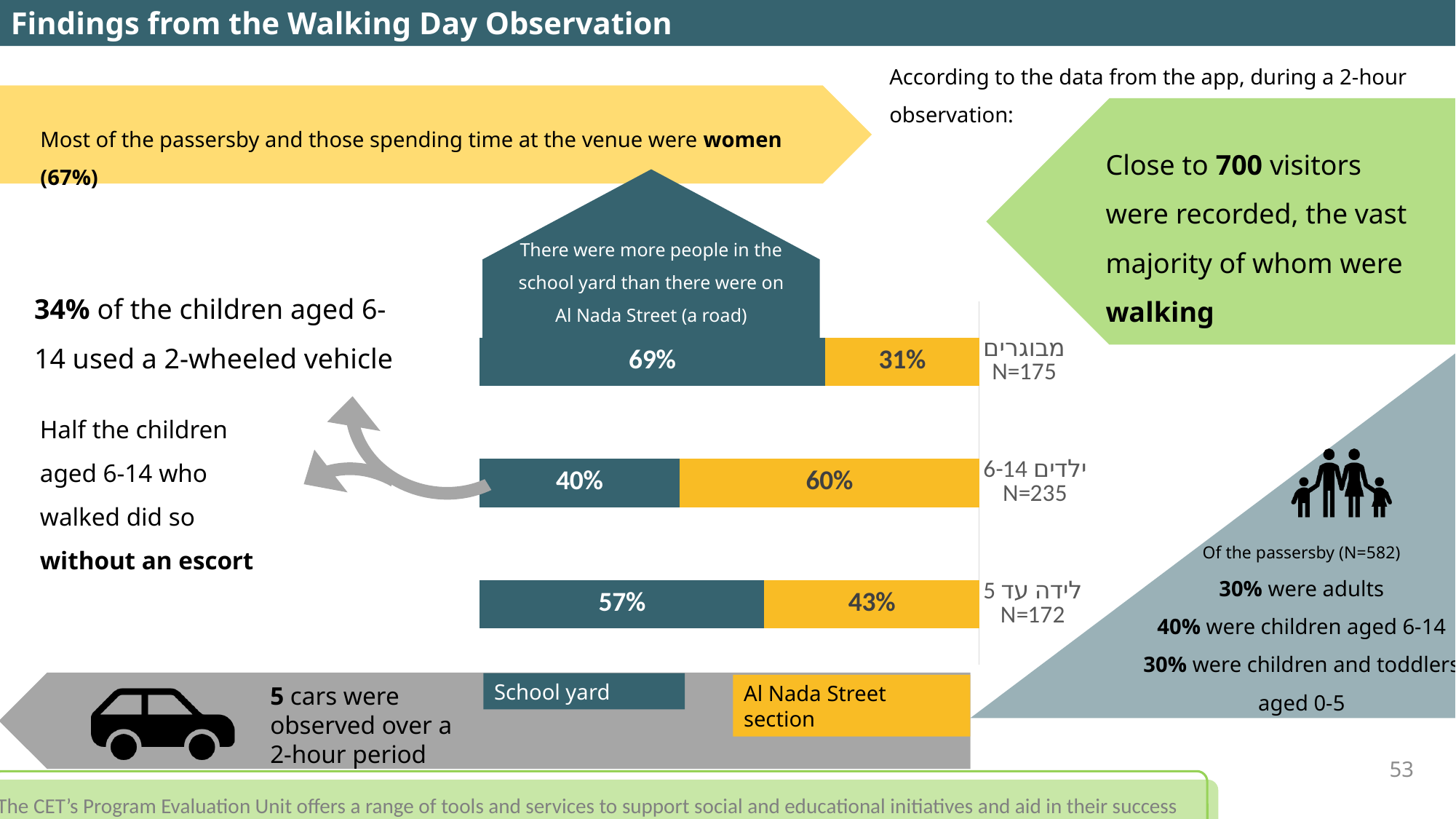
What is the School yard value for the category labelled N=172? 57% What is the difference between the School yard and Al Nada Street section values for the category labelled N=172? 14% What kind of chart is shown in the middle of the slide? stacked bar chart How many categories (bars) does the chart show? 3 Which colour represents the Al Nada Street section series in the chart? orange Which category has the highest School yard value? מבוגרים N=175 What is the Al Nada Street section value for the category labelled N=235? 60% What is the Al Nada Street section value for the category labelled N=175? 31% Which category has the lowest School yard value? ילדים 6-14 N=235 What is the School yard value for the category labelled N=175? 69% For the category labelled N=235, which is larger: the School yard value or the Al Nada Street section value? Al Nada Street section How many series does the chart's legend list? 2